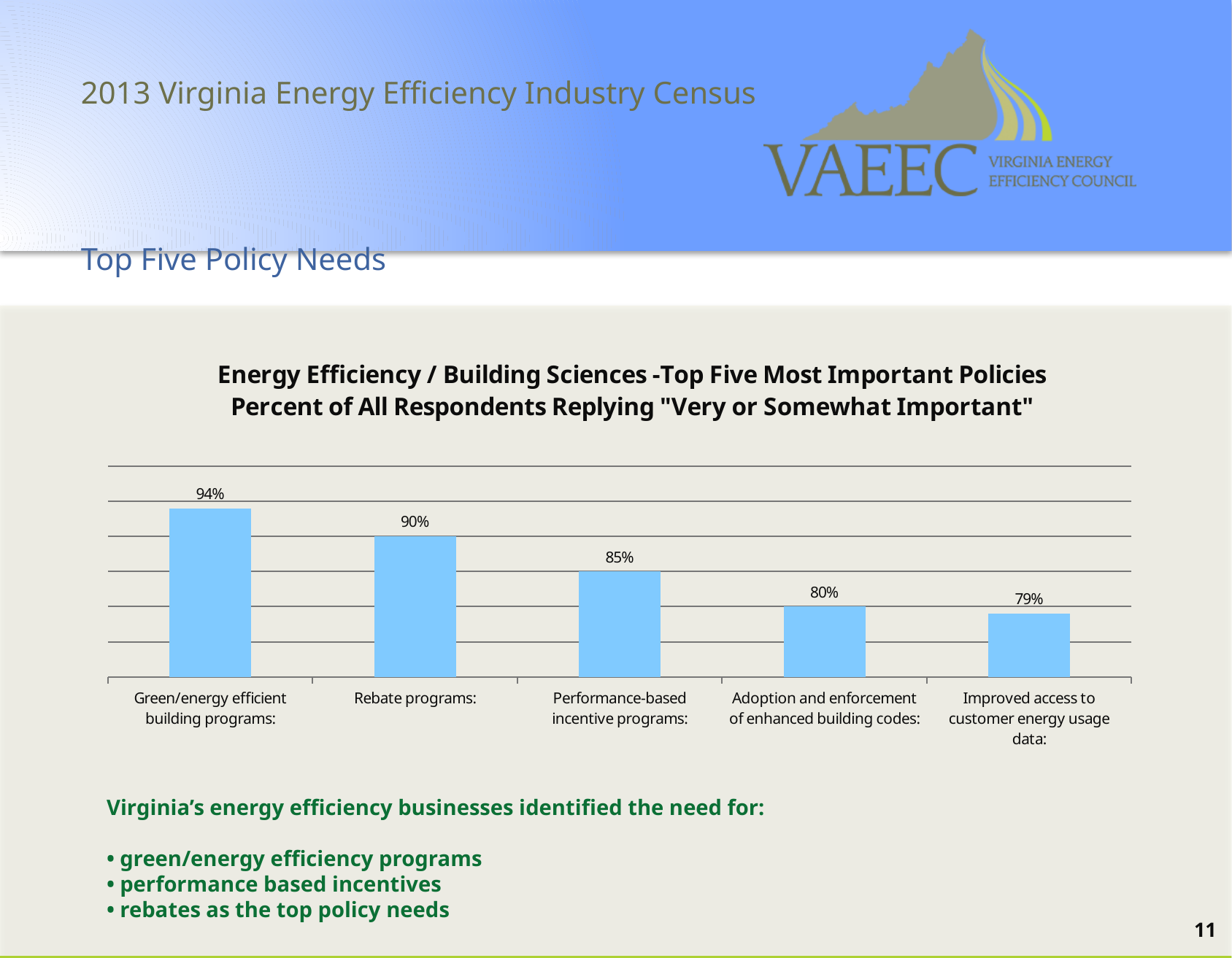
Which has a higher value: Rebate programs or Performance-based incentive programs? Rebate programs Do the values rise or fall from left to right across the chart? Fall What percentage of respondents rated Green/energy efficient building programs as very or somewhat important? 94% What is the value shown for Improved access to customer energy usage data? 79% Which policy has the lowest percentage in the chart? Improved access to customer energy usage data What is the difference in percentage points between Green/energy efficient building programs and Rebate programs? 4 percentage points What type of chart is used on this slide? Bar chart Which policy has the highest percentage of respondents rating it very or somewhat important? Green/energy efficient building programs What is the value shown for Rebate programs? 90% What is the value shown for Performance-based incentive programs? 85% What is the value shown for Adoption and enforcement of enhanced building codes? 80% How many policies are shown in the chart? 5